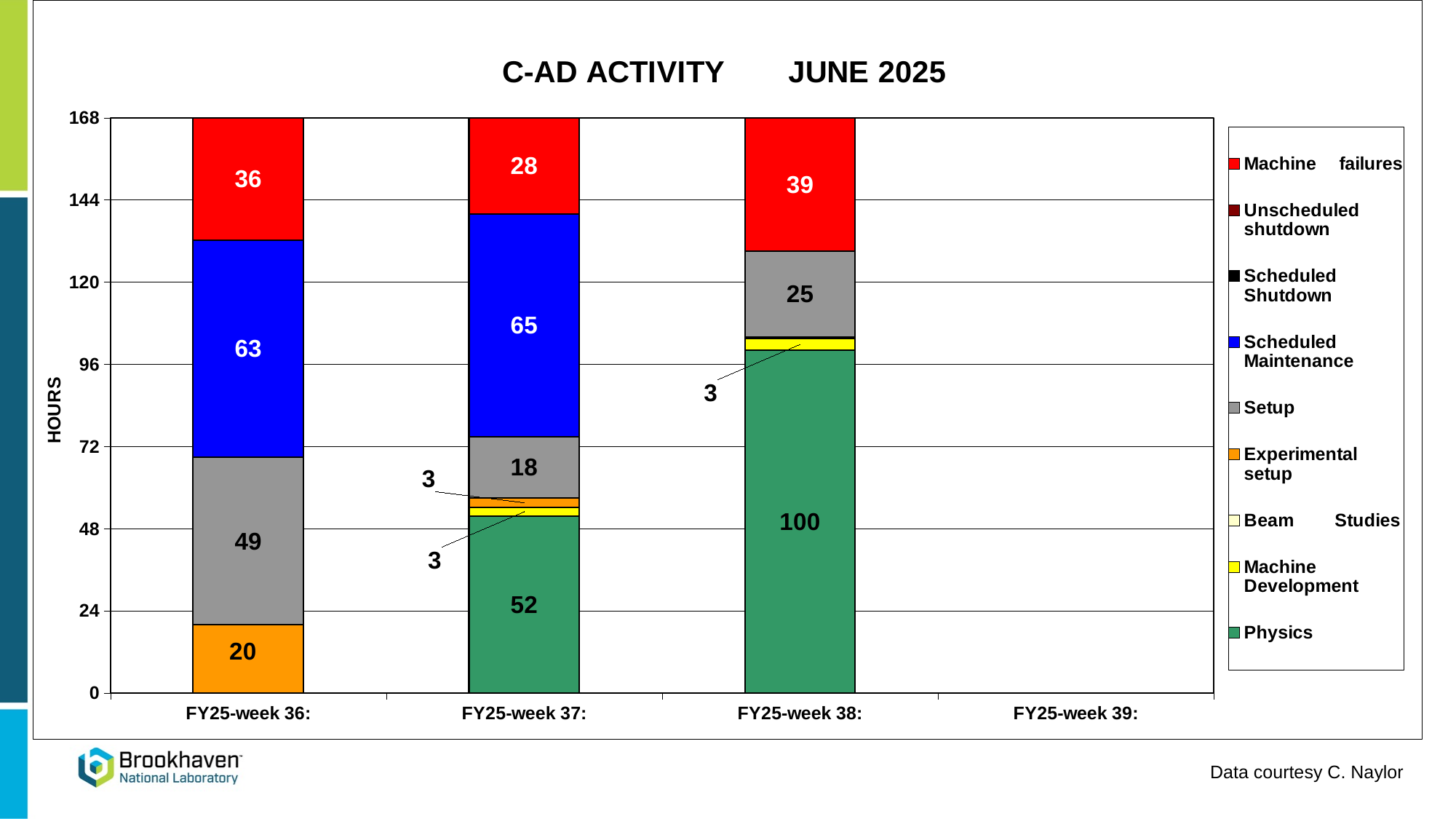
What is the Scheduled Maintenance value for FY25-week 37? 65 What is the difference in Physics hours between FY25-week 38 and FY25-week 37? 48 How many hours of Physics are shown for FY25-week 38? 100 What is the label on the y-axis of the chart? HOURS What kind of chart is shown on the slide? Stacked bar chart Which week has the highest Machine failures value? FY25-week 38 What is the Machine failures value for FY25-week 37? 28 Which week has the lowest Setup value? FY25-week 37 How many Setup hours are shown for FY25-week 36? 49 Which week has more Scheduled Maintenance hours, FY25-week 36 or FY25-week 37? FY25-week 37 What is the total of the stacked bar for FY25-week 36? 168 How many series does the legend list? 9